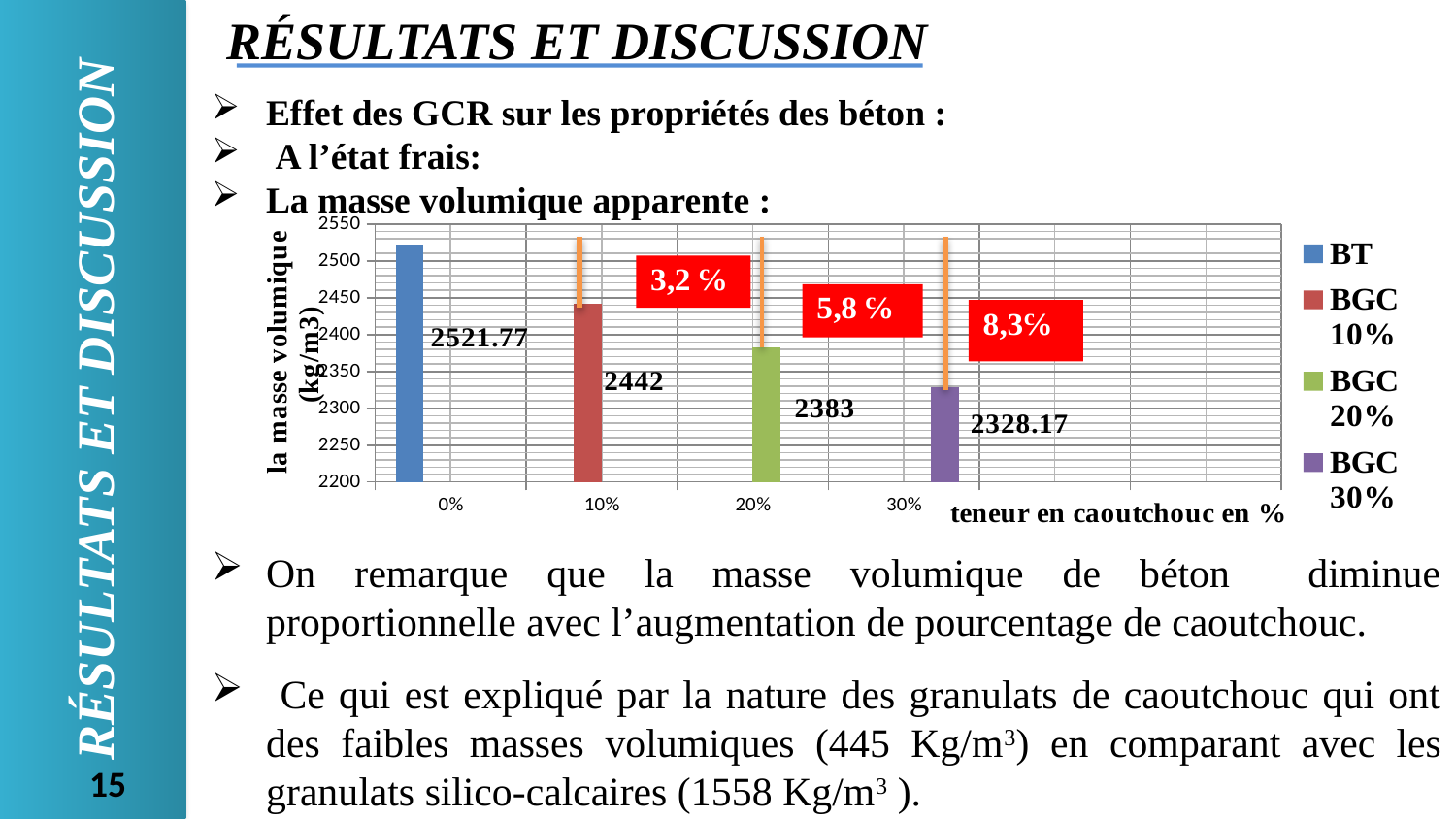
What is the difference between the values at 0% and 30% rubber content? 193.6 How many series does the legend list? 4 What is the value of the bar at 10% rubber content? 2442 Which is larger, the value at 10% or the value at 20% rubber content? 10% What is the value of the bar at 30% rubber content? 2328.17 What is the value of the bar at 0% rubber content? 2521.77 Which rubber content has the lowest apparent density? 30% What kind of chart is shown on the slide? Bar chart What is the value of the bar at 20% rubber content? 2383 Which rubber content has the highest apparent density? 0% What is the difference between the values at 10% and 20% rubber content? 59 How many bars are plotted in the chart? 4